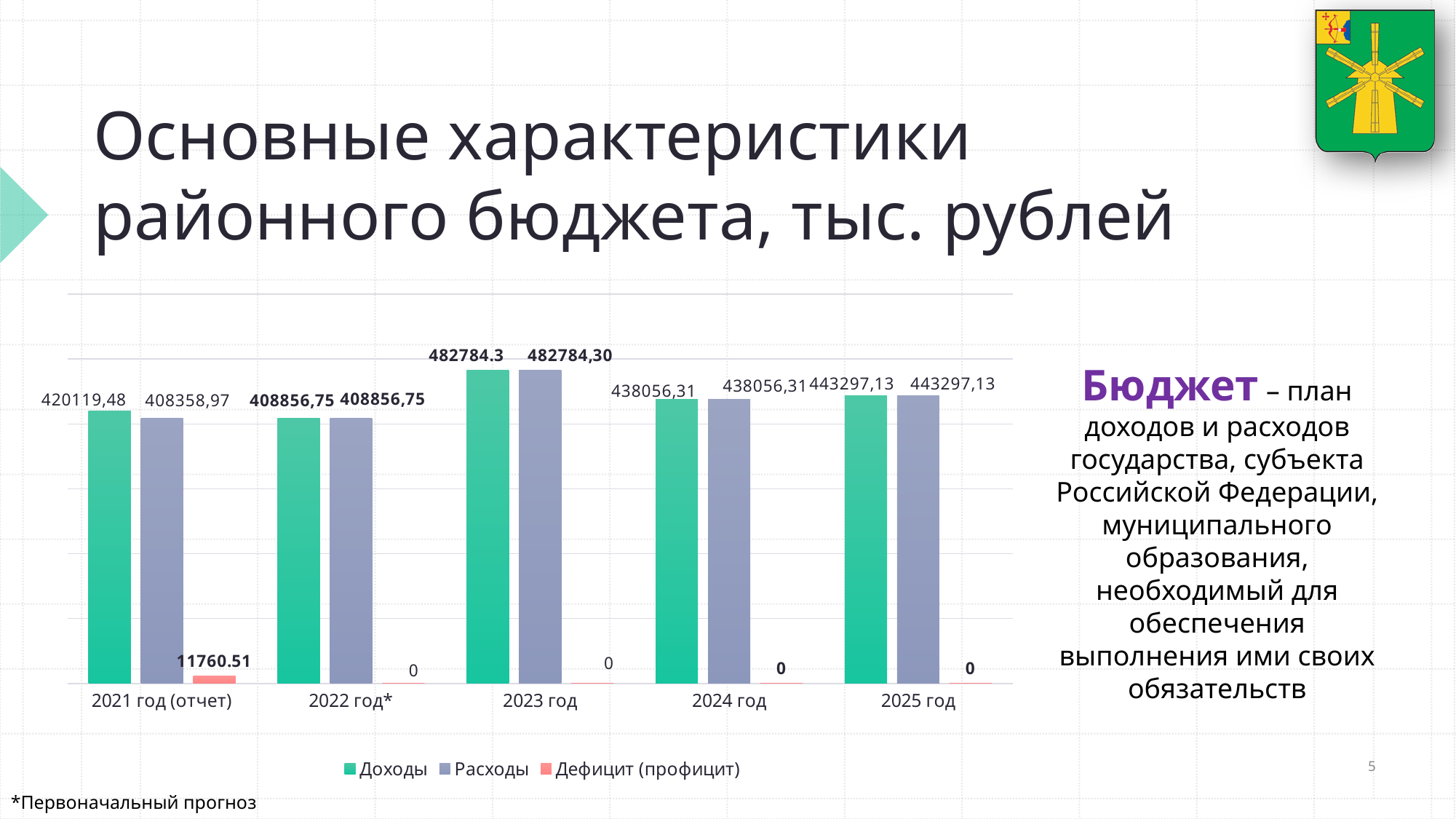
What is the value of Дефицит (профицит) for 2021 год (отчет)? 11760.51 What is the value of Расходы for 2021 год (отчет)? 408358,97 What is the value of Расходы for 2025 год? 443297,13 For 2021 год (отчет), which is larger: Доходы or Расходы? Доходы In which year is Доходы the highest? 2023 год What type of chart is shown on the slide? bar chart What is the difference between Доходы and Расходы for 2021 год (отчет)? 11760,51 What is the value of Доходы for 2023 год? 482784.3 How many series does the chart legend list? 3 How many year categories are shown on the x axis of the chart? 5 In which year is Доходы the lowest? 2022 год* What is the value of Доходы for 2021 год (отчет)? 420119,48